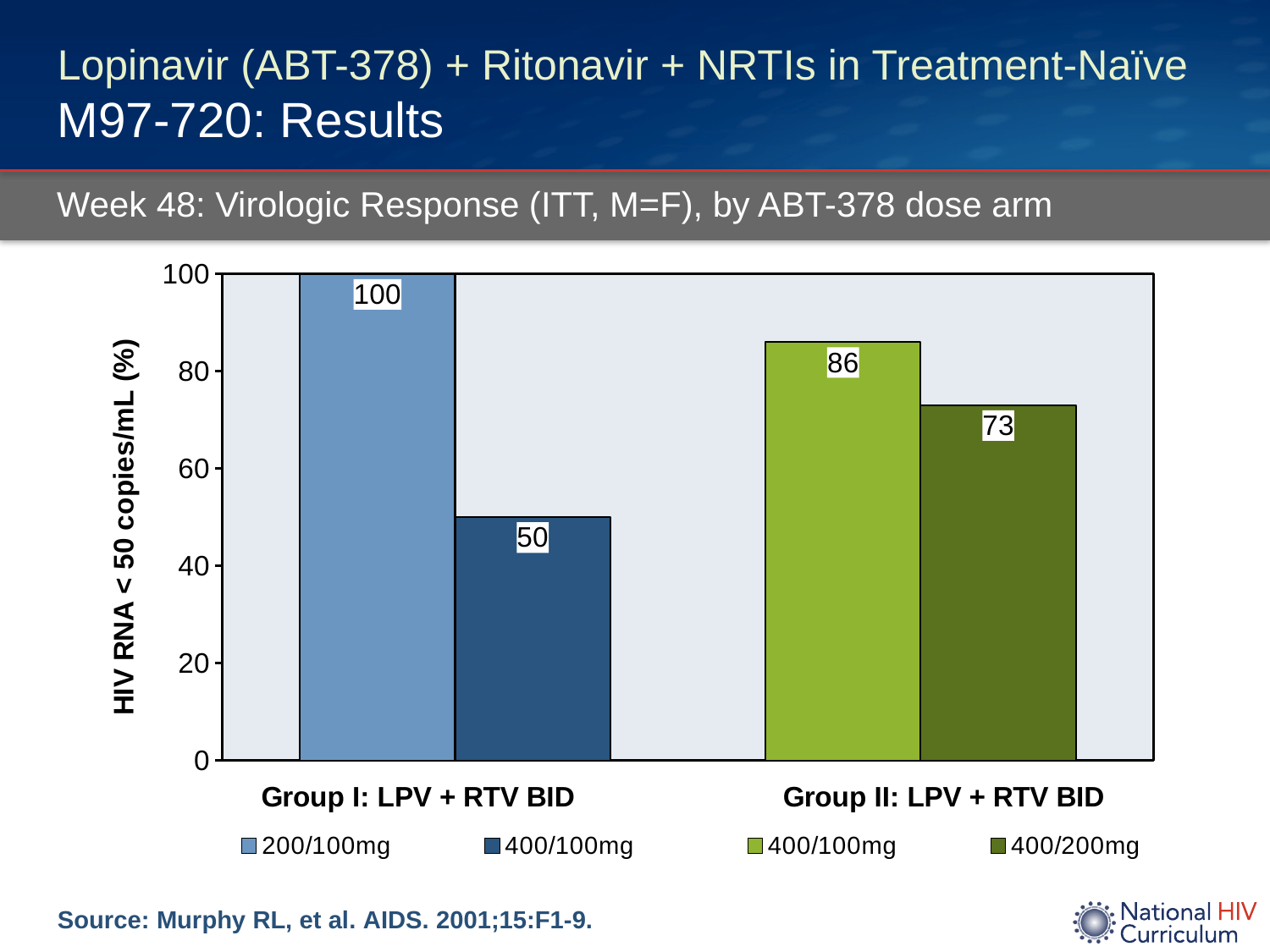
What is the difference between the 200/100mg and 400/100mg arms in Group I? 50 What is the value for the 400/100mg arm in Group II: LPV + RTV BID? 86 What is the value for the 200/100mg arm in Group I: LPV + RTV BID? 100 What type of chart is shown on the slide? Bar chart What is the value for the 400/200mg arm in Group II: LPV + RTV BID? 73 Which dose arm has the highest value on the chart? 200/100mg (Group I) Which is larger: the 400/100mg arm in Group I or the 400/200mg arm in Group II? 400/200mg in Group II How many bars are plotted on the chart? 4 What is the difference between the 400/100mg and 400/200mg arms in Group II? 13 How many entries does the legend list? 4 Which dose arm has the lowest value on the chart? 400/100mg (Group I) What is the value for the 400/100mg arm in Group I: LPV + RTV BID? 50